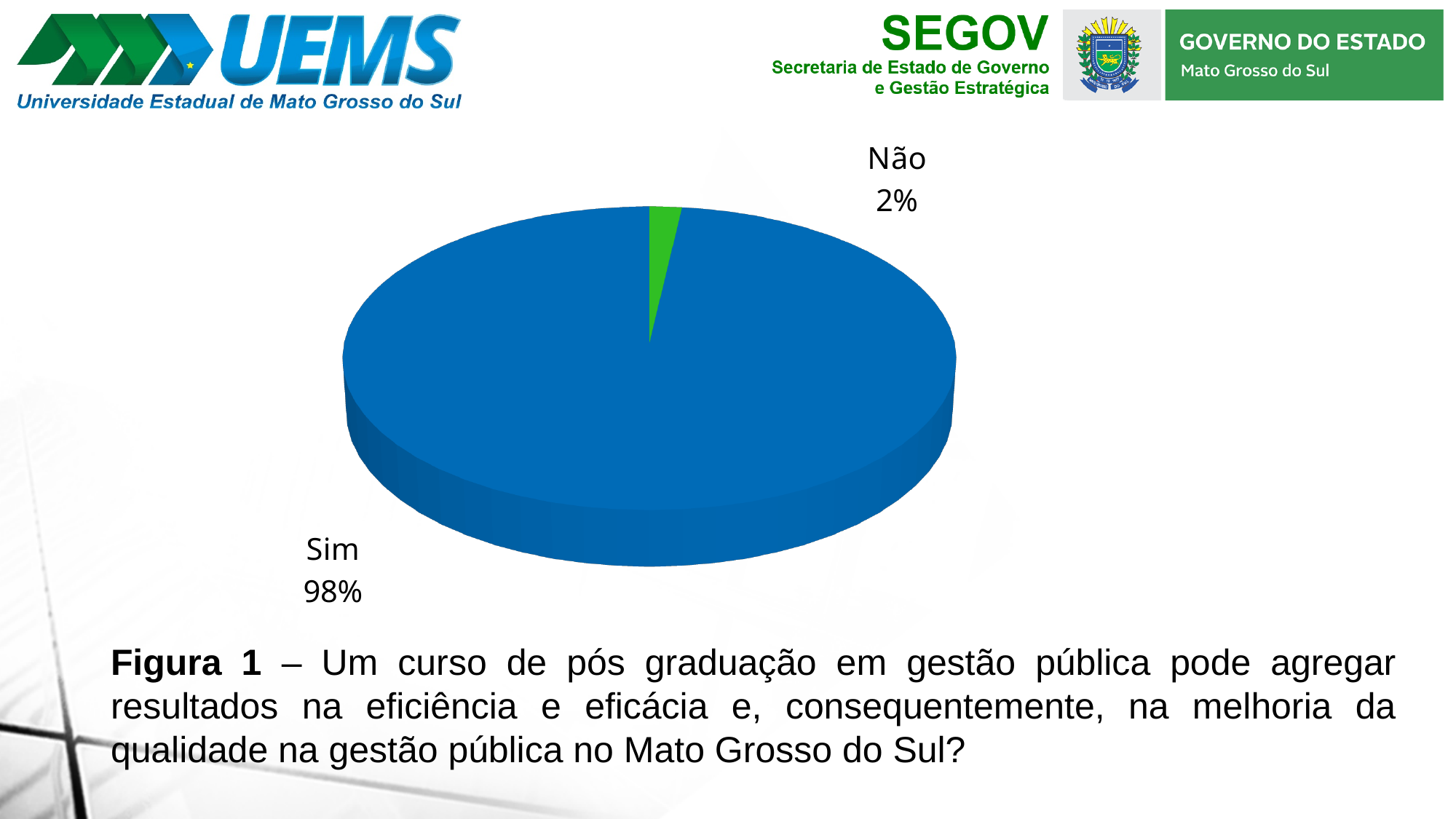
How many categories (slices) does the pie chart have? 2 Which category has the largest share of the pie? Sim What is the difference in percentage points between "Sim" and "Não"? 96 What share of the pie does the "Não" slice represent? 2% Which is larger, the share for "Sim" or the share for "Não"? Sim What percentage of respondents answered "Não"? 2% What percentage of respondents answered "Sim"? 98% What colour is the "Não" slice? Green What colour is the "Sim" slice? Blue What kind of chart is shown on the slide? Pie chart Which category has the smallest share of the pie? Não